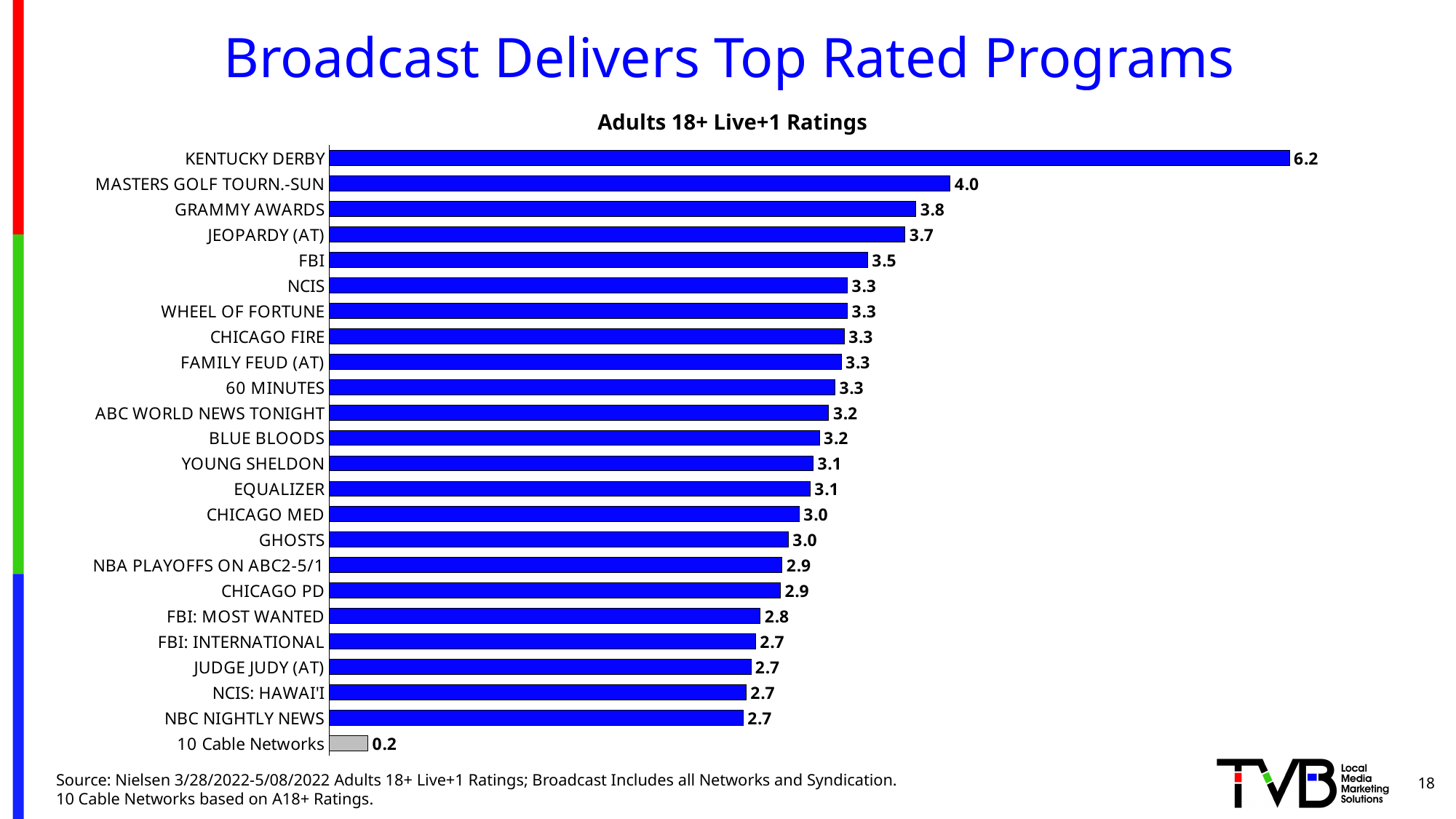
How many bars are plotted on the chart? 24 What is the rating shown for 10 Cable Networks? 0.2 Which program has the highest rating on the chart? KENTUCKY DERBY Which category has the lowest value on the chart? 10 Cable Networks Which has a higher rating, JEOPARDY (AT) or FBI? JEOPARDY (AT) What is the rating shown for FBI: MOST WANTED? 2.8 What is the rating shown for GRAMMY AWARDS? 3.8 What is the title of the chart? Adults 18+ Live+1 Ratings What type of chart is shown on the slide? Bar chart Which bar is coloured differently (grey) from the others? 10 Cable Networks What is the difference between the ratings for KENTUCKY DERBY and MASTERS GOLF TOURN.-SUN? 2.2 What is the Adults 18+ Live+1 rating for KENTUCKY DERBY? 6.2